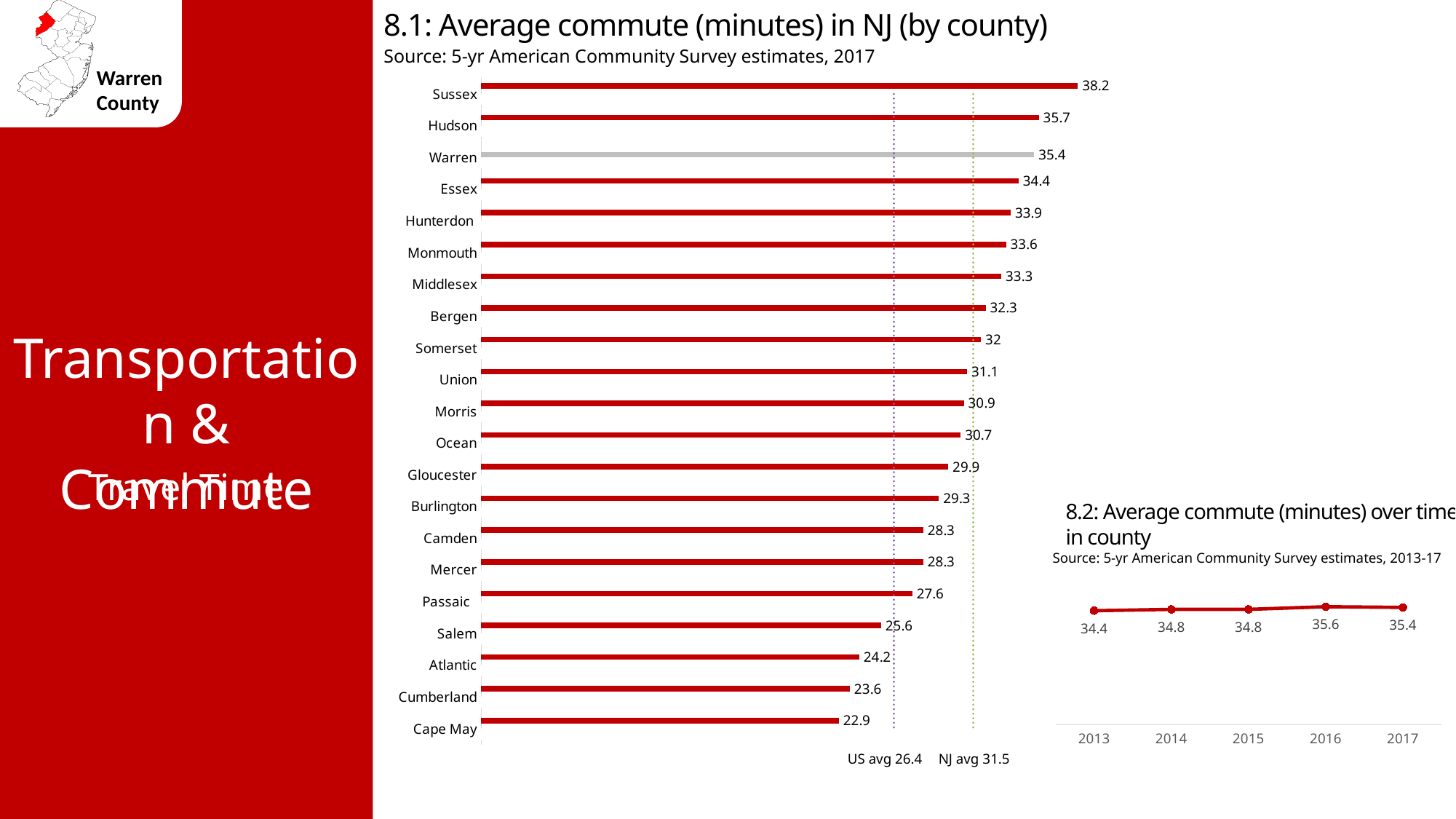
In chart 8.1, which county has the highest average commute? Sussex In chart 8.2, how many years are plotted? 5 In chart 8.2, which year had the highest average commute? 2016 In chart 8.1, what is the difference between the average commute for Sussex and Cape May? 15.3 In chart 8.1, what is the NJ average commute shown by the dotted reference line? 31.5 In chart 8.1, what is the average commute in minutes for Warren County? 35.4 What kind of chart is chart 8.1? bar chart In chart 8.2, what is the difference between the 2017 and 2013 values? 1 In chart 8.1, which county has a longer average commute, Bergen or Morris? Bergen In chart 8.1, how many counties are shown? 21 In chart 8.1, which county has the lowest average commute? Cape May In chart 8.2, what was the average commute in Warren County in 2016? 35.6